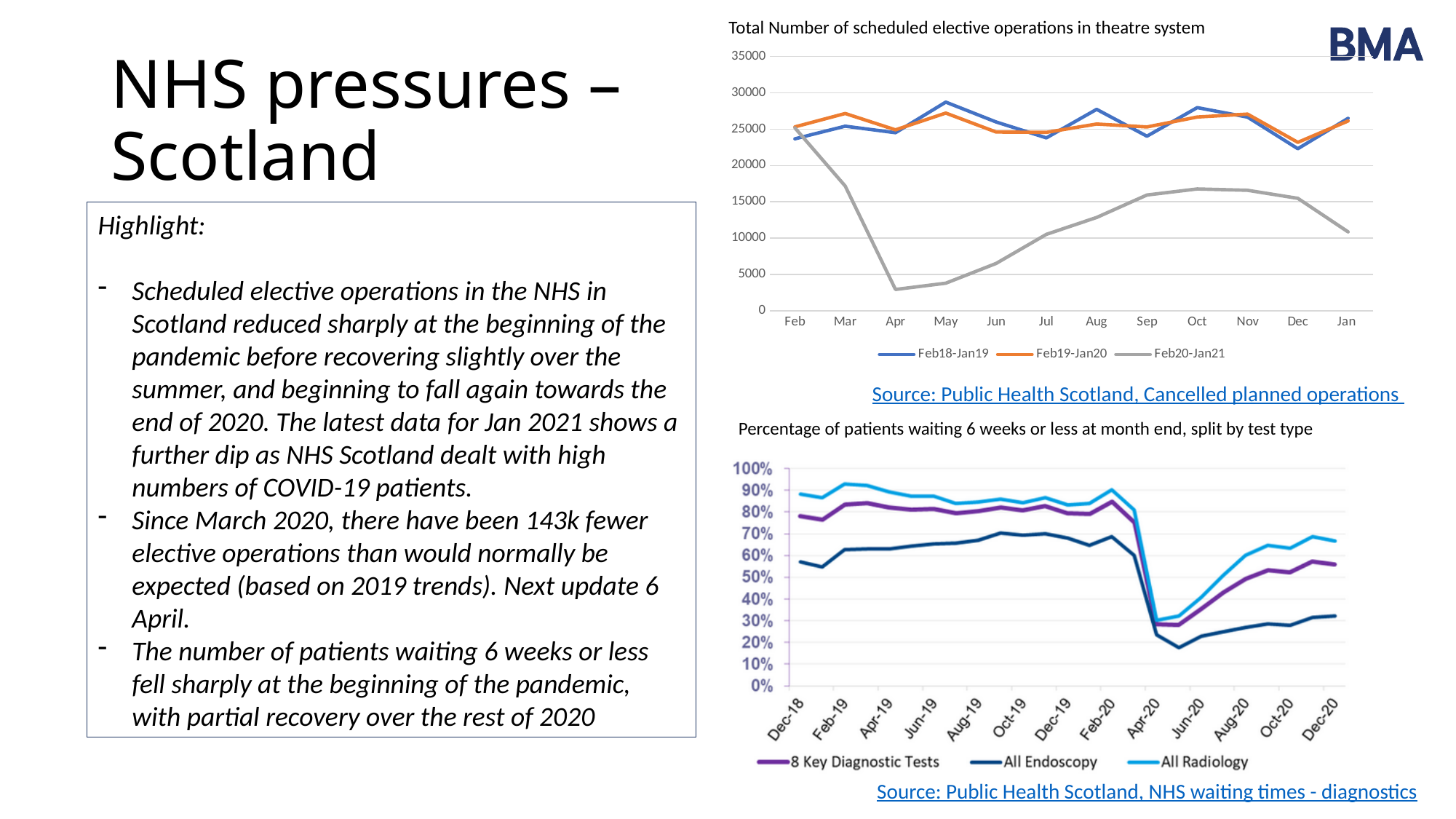
How many months are shown on the x axis of the top chart (scheduled elective operations)? 12 In the bottom chart (percentage of patients waiting 6 weeks or less), which series is higher at Dec-18: All Radiology or All Endoscopy? All Radiology What type of chart is the top chart titled 'Total Number of scheduled elective operations in theatre system'? line chart In the top chart (scheduled elective operations), in which month does the Feb20-Jan21 series reach its lowest value? Apr In the bottom chart (percentage of patients waiting 6 weeks or less), is the All Radiology value for Dec-20 greater or less than 60%? greater How many series does the legend of the top chart (scheduled elective operations) list? 3 In the top chart (scheduled elective operations), does the Feb20-Jan21 series rise or fall from Feb to Apr? fall In the top chart (scheduled elective operations), is the Feb18-Jan19 value for May greater or less than 25000? greater In the top chart (scheduled elective operations), which series is lower in Jul: Feb19-Jan20 or Feb20-Jan21? Feb20-Jan21 How many series does the legend of the bottom chart (percentage of patients waiting 6 weeks or less) list? 3 In the top chart (scheduled elective operations), is the Feb20-Jan21 value for Apr greater or less than 5000? less